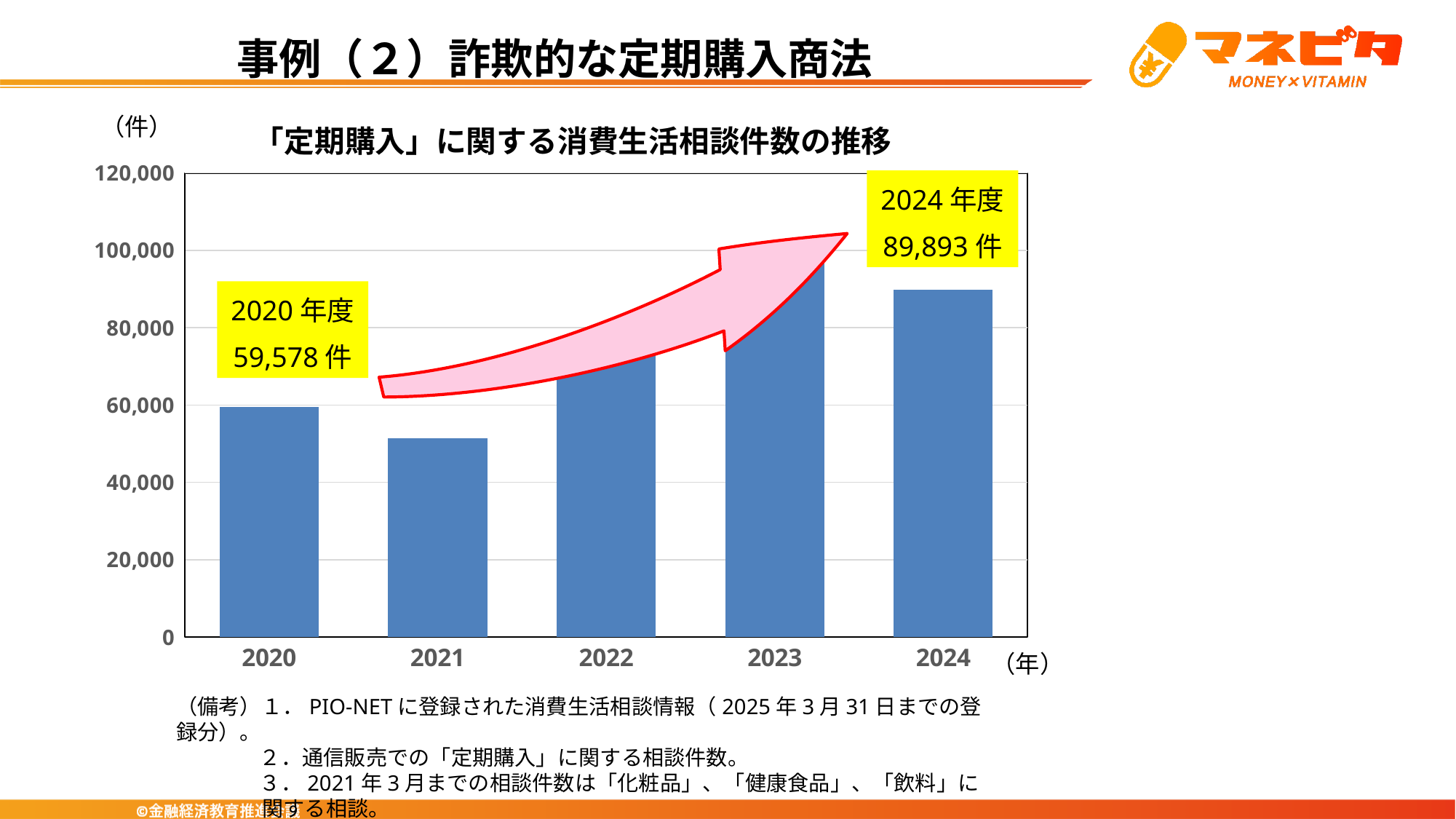
Which is larger, the value for 2023 or the value for 2024? 2023 Which year has the lowest number of consultations? 2021 Is the value for 2023 greater or less than 80,000? greater How many years are shown on the x axis of the chart? 5 Is the value for 2022 greater or less than 60,000? greater What is the difference between the 2024 value and the 2020 value? 30,315 件 What is the title of the chart? 「定期購入」に関する消費生活相談件数の推移 Is the value for 2021 greater or less than 60,000? less What is the value for 2020 in the chart? 59,578 件 What kind of chart is shown on the slide? bar chart Which year has the highest number of consultations? 2023 What is the value for 2024 in the chart? 89,893 件